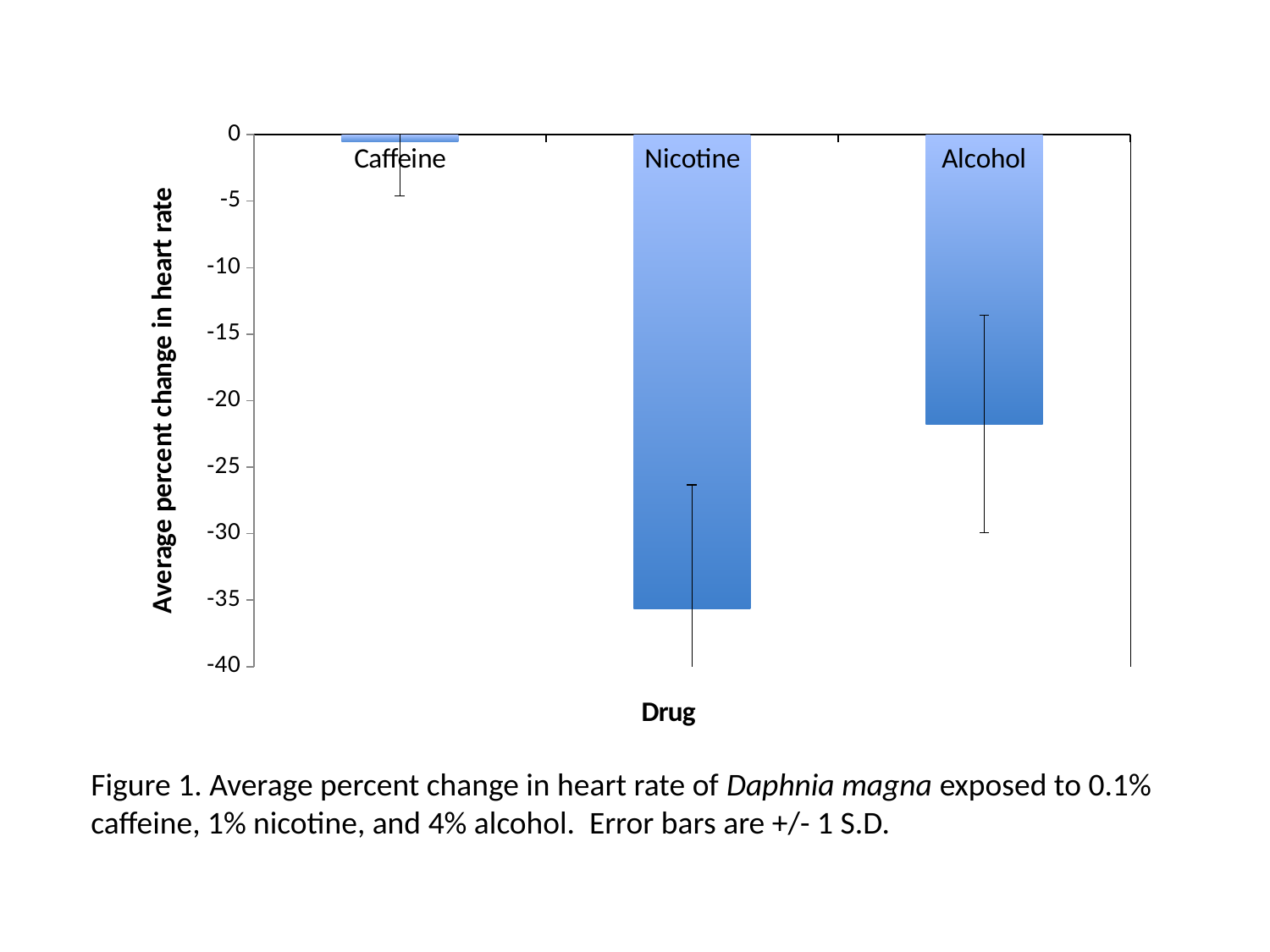
Which drug has the lowest (most negative) average percent change in heart rate? Nicotine Is the value for Nicotine greater or less than -30? less Which value is larger, the average percent change for Caffeine or for Alcohol? Caffeine Is the value for Alcohol greater or less than -25? greater Which drug has the highest average percent change in heart rate (closest to zero)? Caffeine Is the value for Alcohol greater or less than -20? less What is the label of the vertical axis? Average percent change in heart rate How many drugs (categories) are plotted in the chart? 3 What is the label of the horizontal axis? Drug Which bar extends further below zero, Nicotine or Alcohol? Nicotine What kind of chart is shown on the slide? bar chart